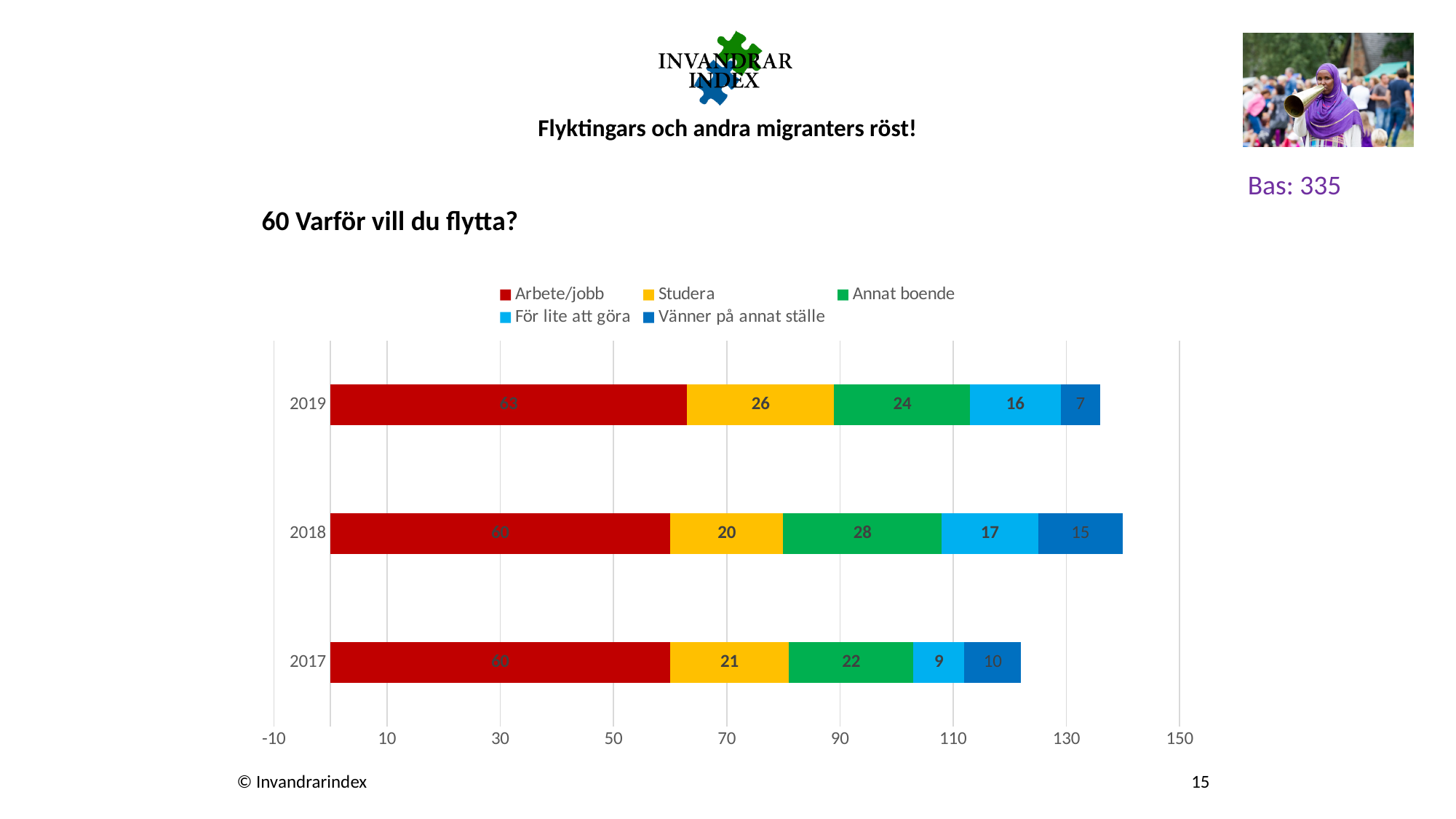
What is the total of the stacked bar for 2018? 140 Which year has the highest value for Studera? 2019 What is the value for Vänner på annat ställe in 2019? 7 What is the value for Arbete/jobb in 2019? 63 What is the value for Annat boende in 2018? 28 What is the difference between the Annat boende values for 2018 and 2017? 6 How many years are shown on the chart? 3 What type of chart is shown on the slide? Stacked bar chart Which is larger, the För lite att göra value for 2018 or for 2017? 2018 Which year has the lowest value for Vänner på annat ställe? 2019 How many series does the legend list? 5 What is the value for För lite att göra in 2017? 9